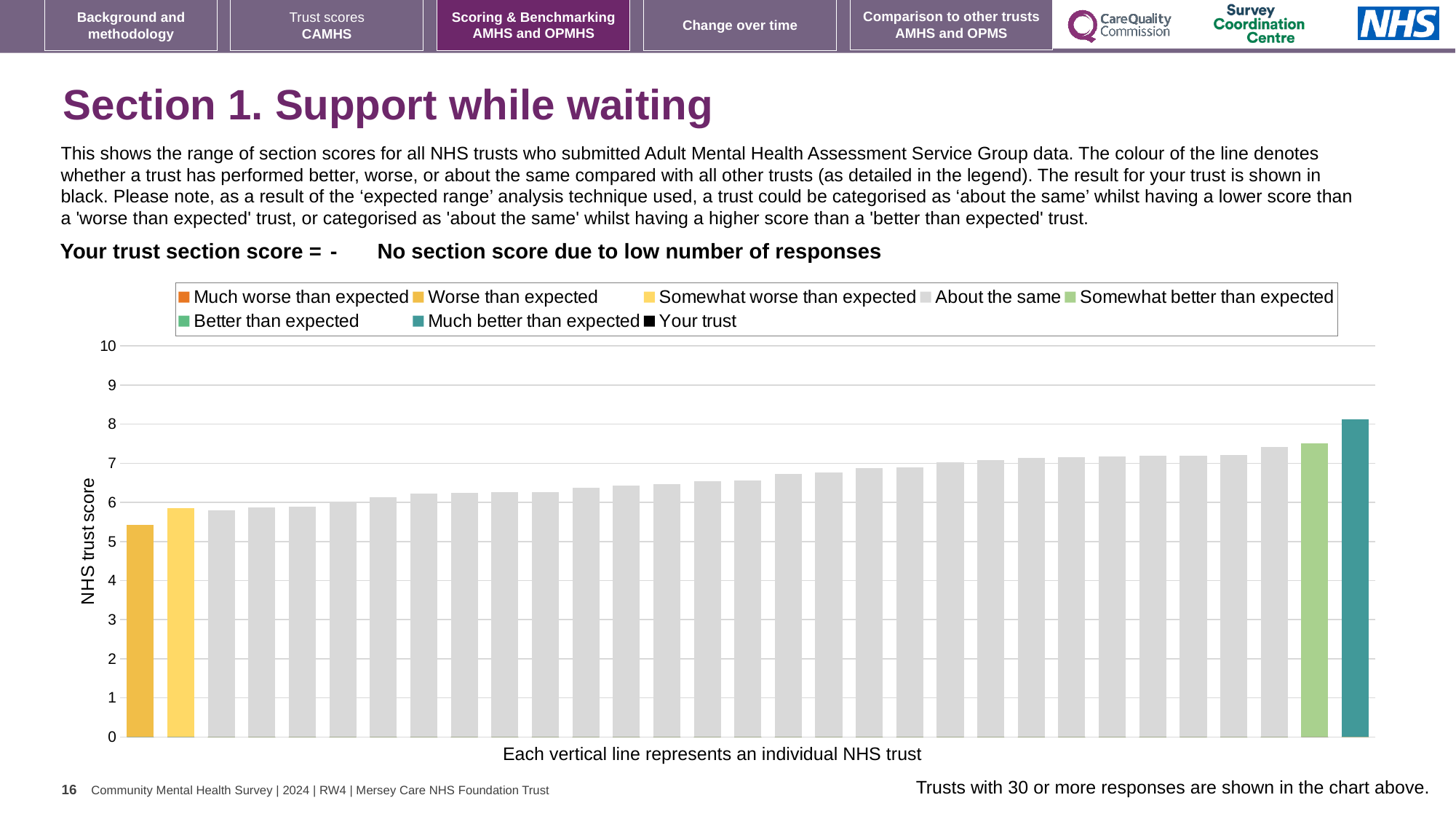
Is the value of the shortest bar greater or less than 6? less How many entries does the chart legend list? 8 Which legend category does the tallest bar (rightmost) belong to? Much better than expected Which is taller: the 'Much better than expected' bar or the 'Somewhat better than expected' bar? Much better than expected What kind of chart is shown on the slide? bar chart Is the value of the 'Somewhat better than expected' bar greater or less than 7? greater Is the value of the 'Somewhat worse than expected' bar greater or less than 7? less Do the bar values rise or fall from left to right along the x axis? rise Which legend category does the shortest bar (leftmost) belong to? Worse than expected What is the label of the vertical axis? NHS trust score What is the highest value shown on the vertical axis? 10